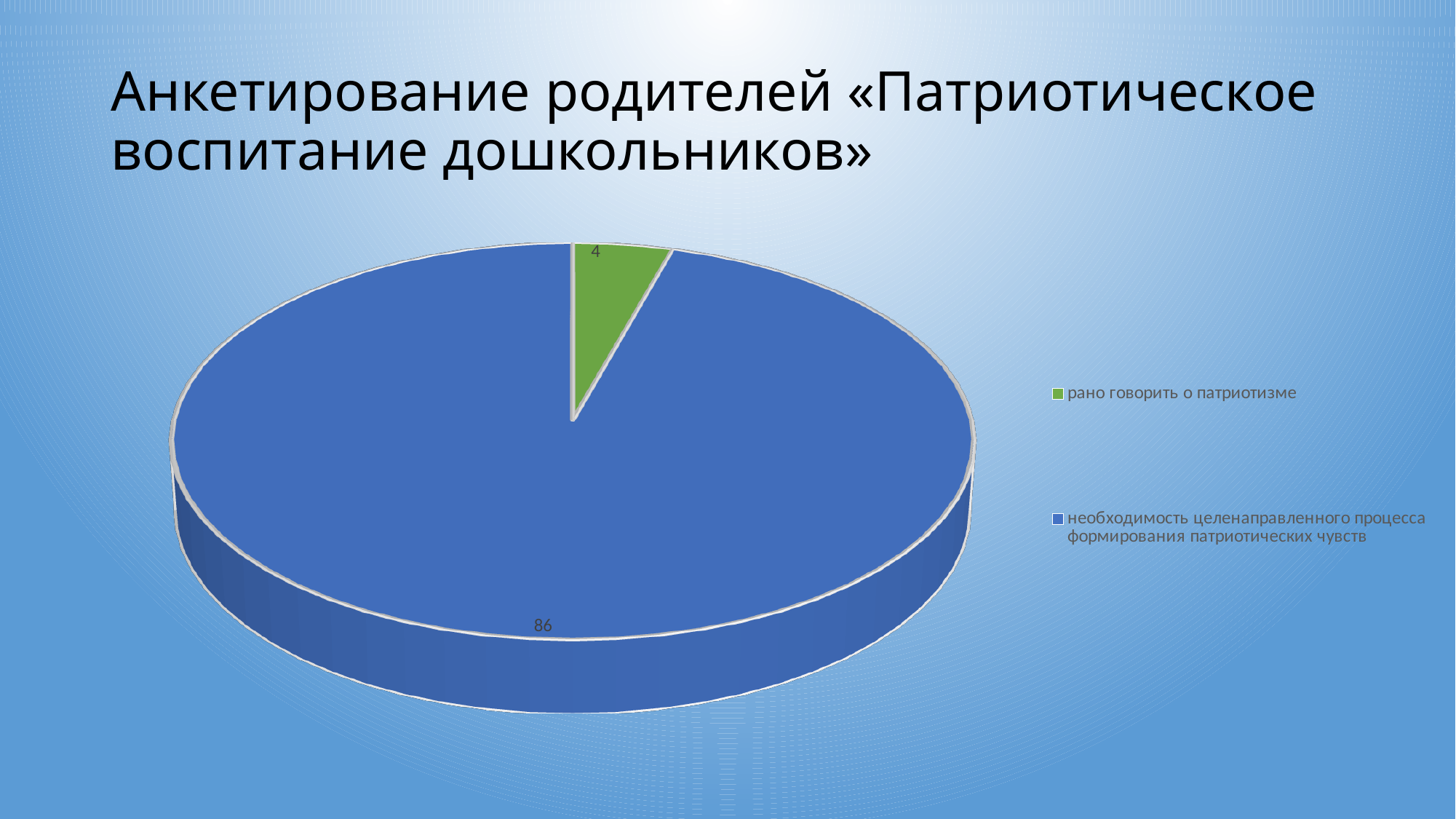
Which is larger: the value for "рано говорить о патриотизме" or the value for "необходимость целенаправленного процесса формирования патриотических чувств"? необходимость целенаправленного процесса формирования патриотических чувств What is the total of all the values shown in the pie chart? 90 How many entries does the legend list? 2 What is the value for "рано говорить о патриотизме"? 4 Which category has the largest slice of the pie? необходимость целенаправленного процесса формирования патриотических чувств What is the difference between the values for "необходимость целенаправленного процесса формирования патриотических чувств" and "рано говорить о патриотизме"? 82 What is the value for "необходимость целенаправленного процесса формирования патриотических чувств"? 86 What is the title of the slide containing the chart? Анкетирование родителей «Патриотическое воспитание дошкольников» How many slices does the pie chart have? 2 What kind of chart is shown on the slide? pie chart Which category has the smallest slice of the pie? рано говорить о патриотизме What colour is the slice for "рано говорить о патриотизме"? green